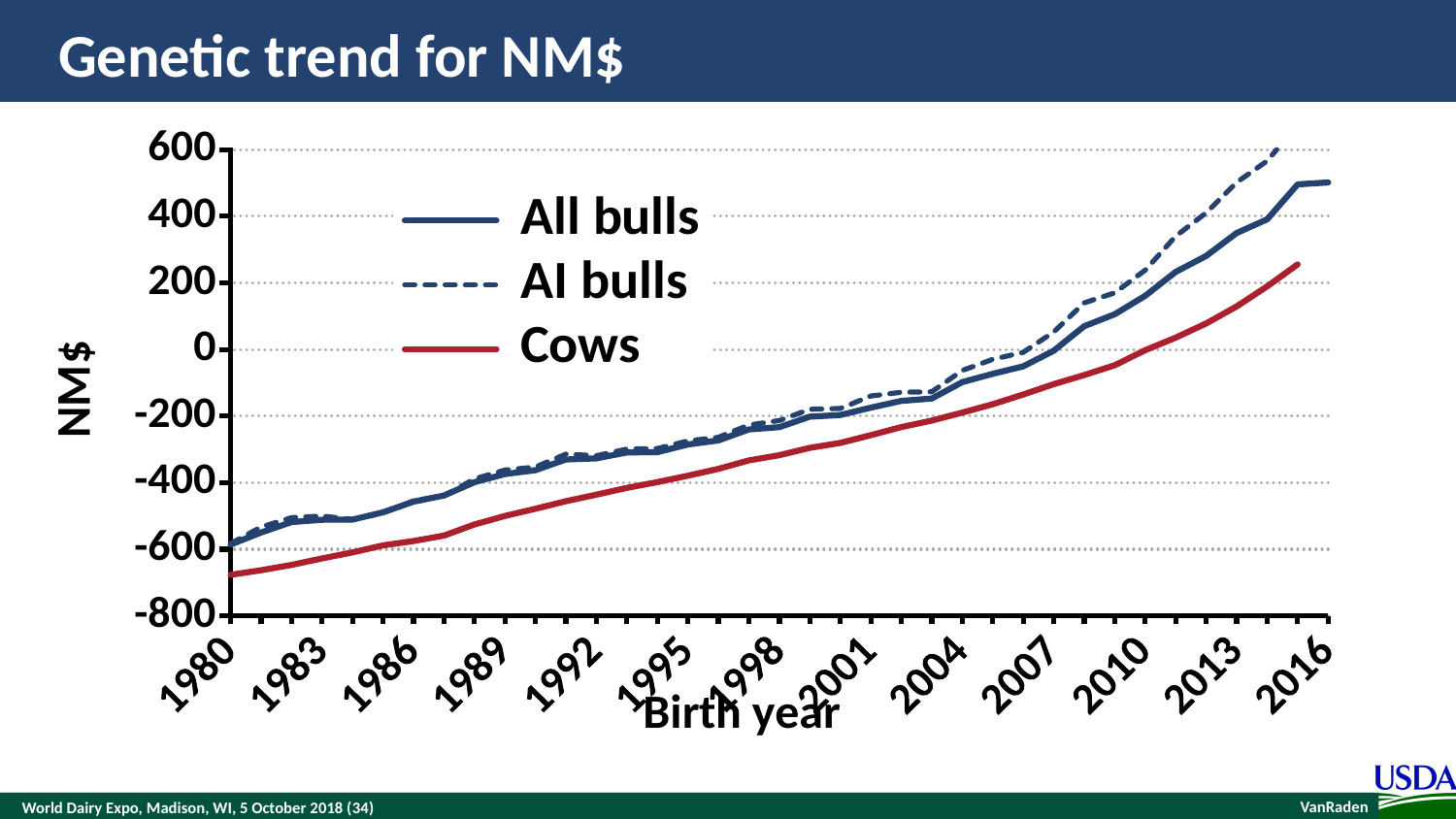
Do the NM$ values for All bulls rise or fall from 1980 to 2016? Rise What is the title of the chart? Genetic trend for NM$ Is the value for Cows in 1980 greater or less than -600? less How many series does the legend list? 3 In 2010, which series has the higher NM$ value, AI bulls or Cows? AI bulls Is the value for All bulls in 2010 greater or less than 0? greater Is the value for Cows in 2007 greater or less than 0? less What kind of chart is shown on the slide? Line chart Which series is drawn with a dashed line? AI bulls Do the NM$ values for Cows rise or fall as birth year increases? Rise